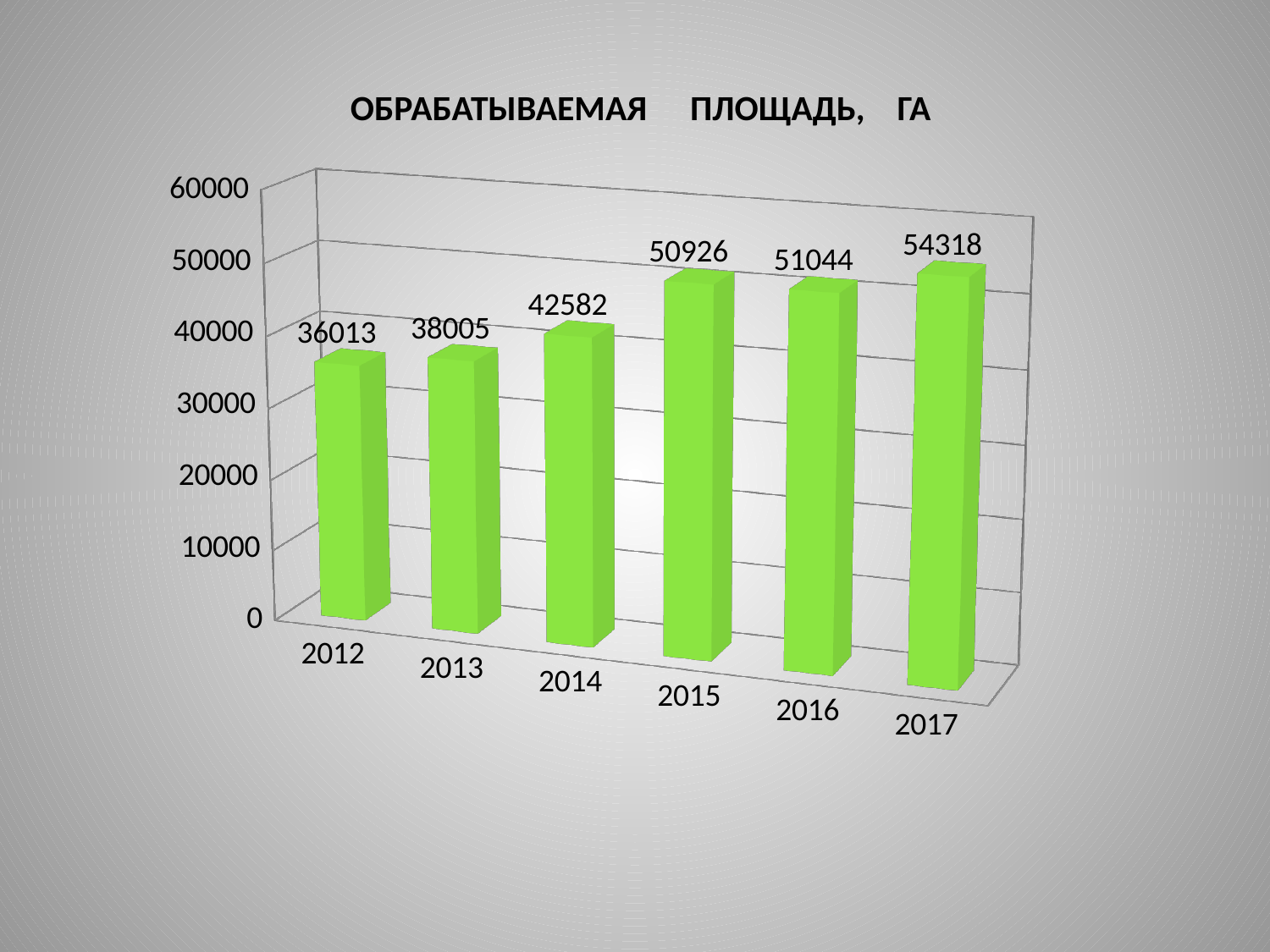
How many years are shown on the chart? 6 Do the values rise or fall from 2012 to 2017? rise Which year has the highest cultivated area? 2017 What value is shown for 2017? 54318 What is the value for 2012? 36013 Which year has the lowest cultivated area? 2012 What is the difference between the values for 2015 and 2014? 8344 What is the difference between the values for 2017 and 2016? 3274 Is the value for 2015 greater or less than 40000? greater What is the cultivated area in 2014? 42582 Which is larger, the value for 2013 or the value for 2014? 2014 What kind of chart is this? bar chart